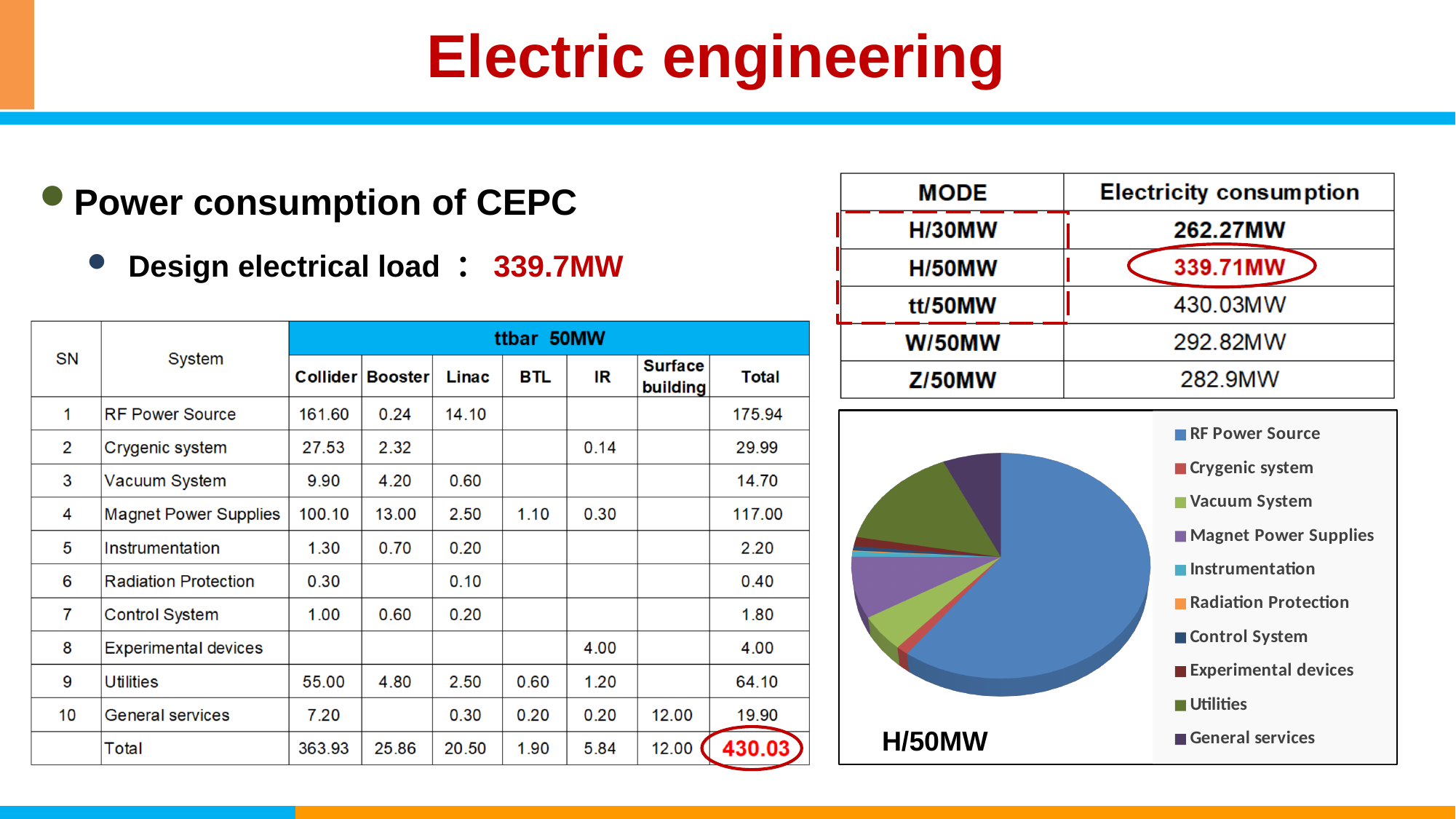
How many categories does the legend of the pie chart list? 10 What operating mode is the pie chart labelled with? H/50MW Which category has the largest slice in the pie chart? RF Power Source In the pie chart, which slice is larger: Magnet Power Supplies or Crygenic system? Magnet Power Supplies What colour is the RF Power Source slice in the pie chart? blue How many slices does the pie chart represent according to its legend? 10 In the pie chart, which slice is larger: RF Power Source or Utilities? RF Power Source What kind of chart is shown on the slide? pie chart In the pie chart, which slice is larger: Utilities or Vacuum System? Utilities